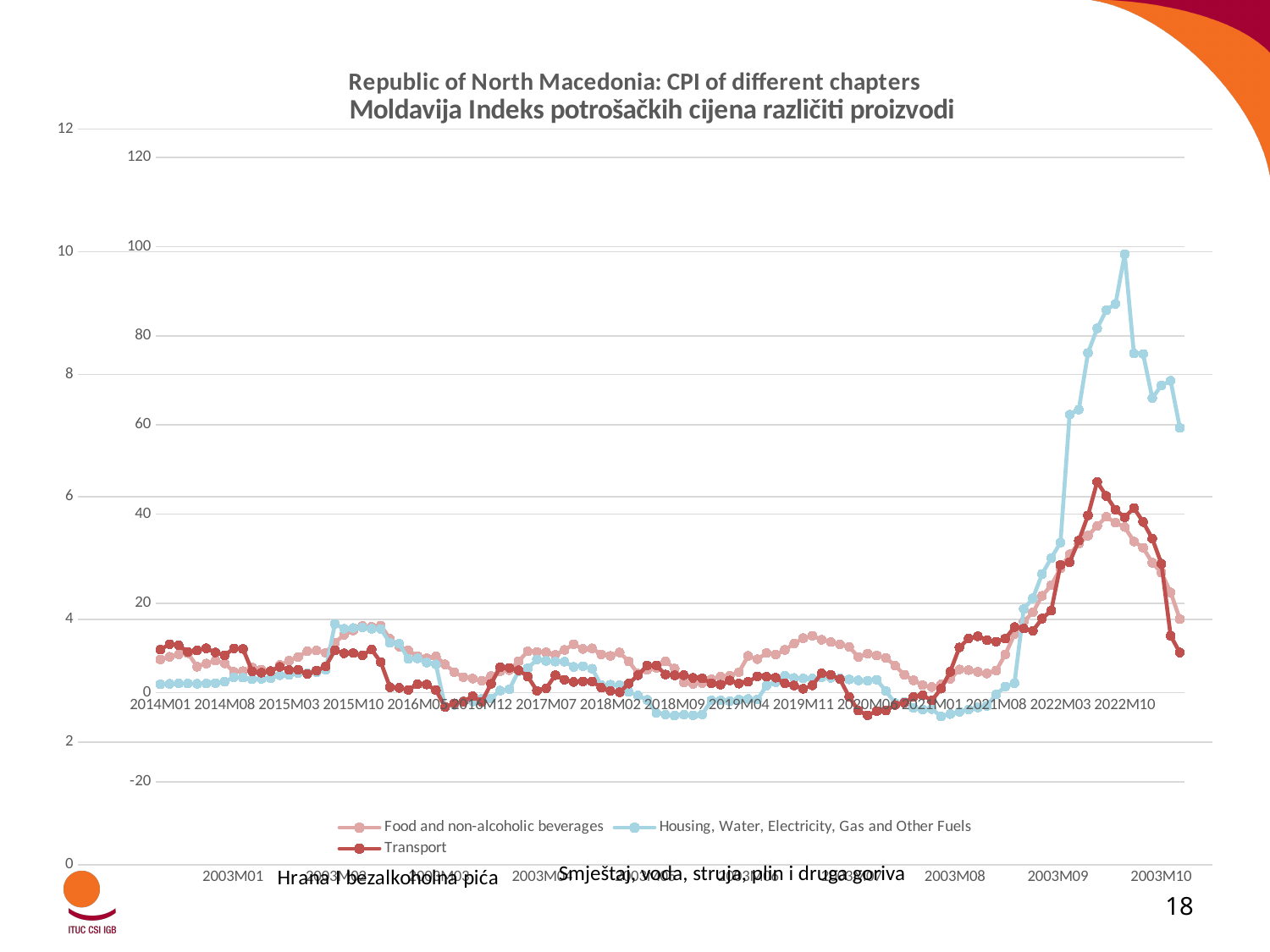
How many series does the legend list? 3 Is the peak value of the Transport series greater or less than 60? less What is the lowest value shown on the vertical axis? -20 What kind of chart is shown on the slide? line chart At the last point on the chart, which is higher: Housing, Water, Electricity, Gas and Other Fuels or Transport? Housing, Water, Electricity, Gas and Other Fuels Which series reaches the highest peak on the chart? Housing, Water, Electricity, Gas and Other Fuels Which colour is used for the Housing, Water, Electricity, Gas and Other Fuels series? light blue What is the title of the chart? Republic of North Macedonia: CPI of different chapters Is the peak value of the Food and non-alcoholic beverages series greater or less than 60? less Does the Housing, Water, Electricity, Gas and Other Fuels series rise or fall between 2021M08 and 2022M03? rise Is the value of the Housing, Water, Electricity, Gas and Other Fuels series at 2014M01 greater or less than 20? less